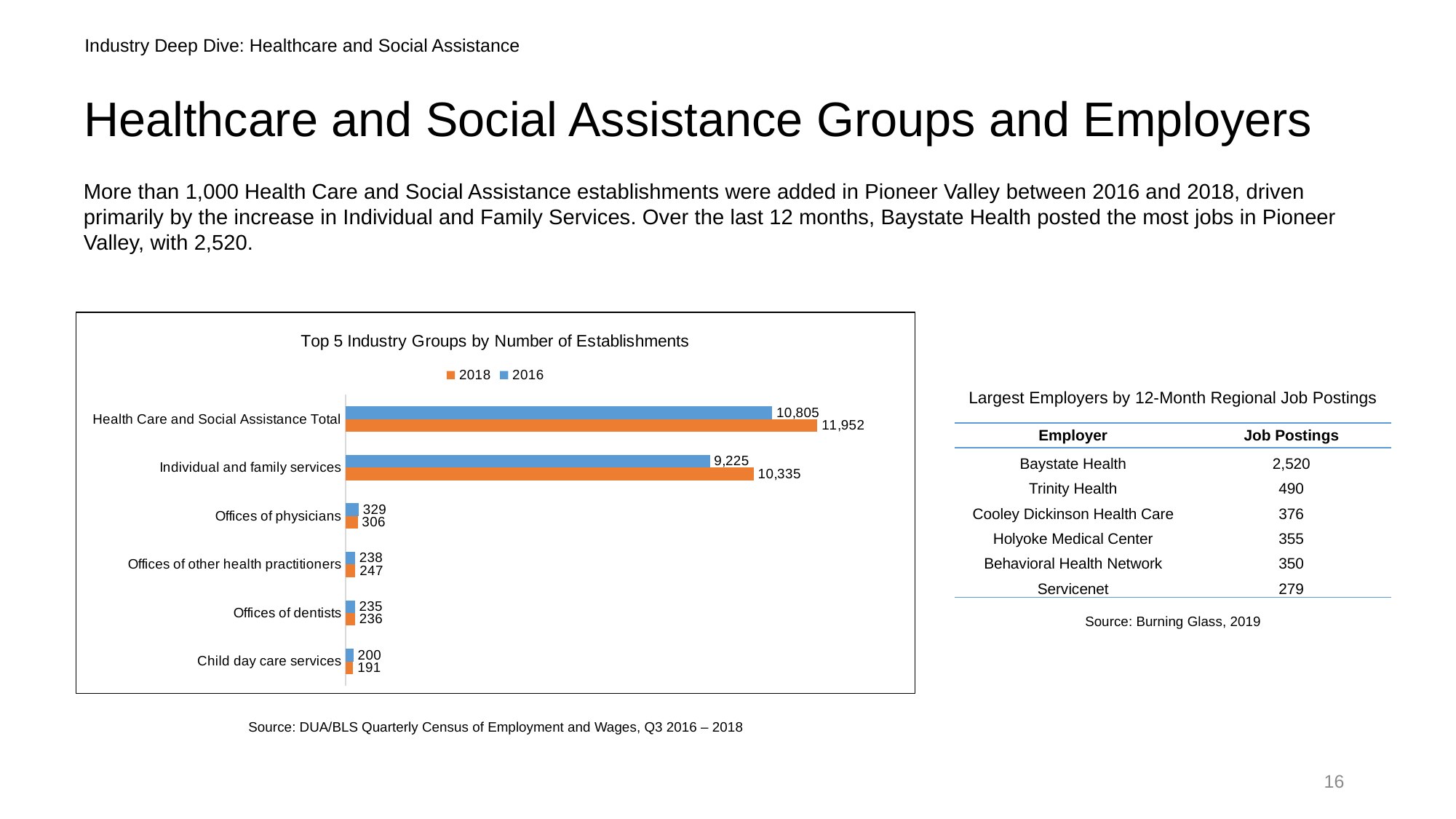
In the "Top 5 Industry Groups by Number of Establishments" chart, what is the difference between the 2018 and 2016 values for Offices of other health practitioners? 9 In the "Top 5 Industry Groups by Number of Establishments" chart, what is the difference between the 2018 and 2016 values for Health Care and Social Assistance Total? 1,147 Which colour represents the 2018 series in the "Top 5 Industry Groups by Number of Establishments" chart? Orange How many series does the legend of the "Top 5 Industry Groups by Number of Establishments" chart list? 2 In the "Top 5 Industry Groups by Number of Establishments" chart, which category has the highest 2016 value? Health Care and Social Assistance Total How many categories are shown on the "Top 5 Industry Groups by Number of Establishments" chart? 6 What is the 2018 value for Child day care services in the "Top 5 Industry Groups by Number of Establishments" chart? 191 In the "Top 5 Industry Groups by Number of Establishments" chart, which category has the lowest 2018 value? Child day care services What is the 2018 value for Individual and family services in the "Top 5 Industry Groups by Number of Establishments" chart? 10,335 In the "Top 5 Industry Groups by Number of Establishments" chart, is the 2016 value for Offices of physicians larger or smaller than its 2018 value? Larger What type of chart is "Top 5 Industry Groups by Number of Establishments"? Bar chart What is the 2016 value for Offices of physicians in the "Top 5 Industry Groups by Number of Establishments" chart? 329